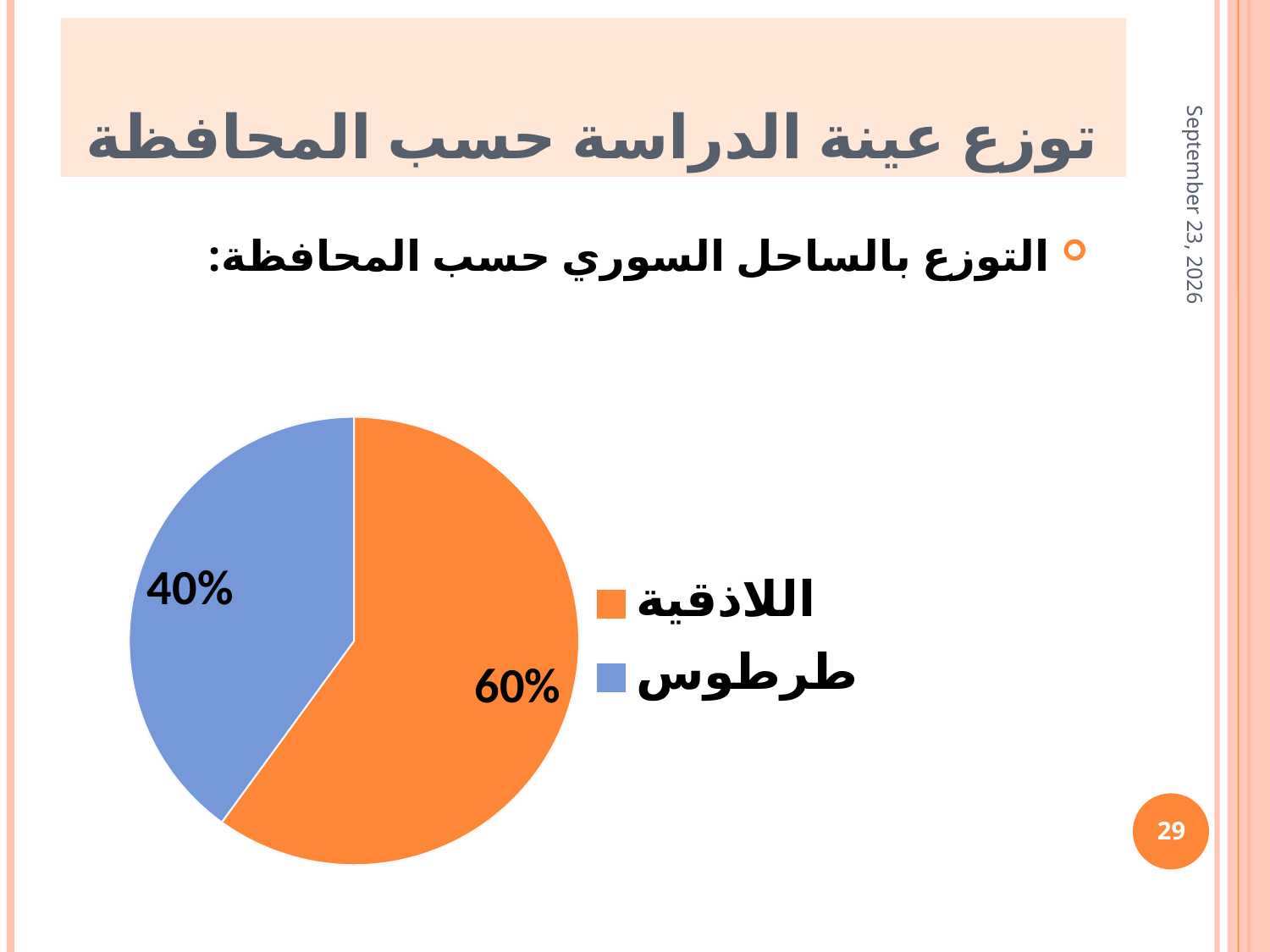
What kind of chart is shown on the slide? Pie chart Which slice is larger, اللاذقية or طرطوس? اللاذقية Which category has the smallest slice of the pie? طرطوس What colour is the slice for اللاذقية? Orange What is the total of the two slices shown in the pie chart? 100% How many categories are shown in the pie chart? 2 What is the difference in percentage points between the اللاذقية slice and the طرطوس slice? 20% Which category has the largest slice of the pie? اللاذقية What share of the pie does اللاذقية (Latakia) account for? 60% What share of the pie does طرطوس (Tartus) account for? 40% What colour is the slice for طرطوس? Blue